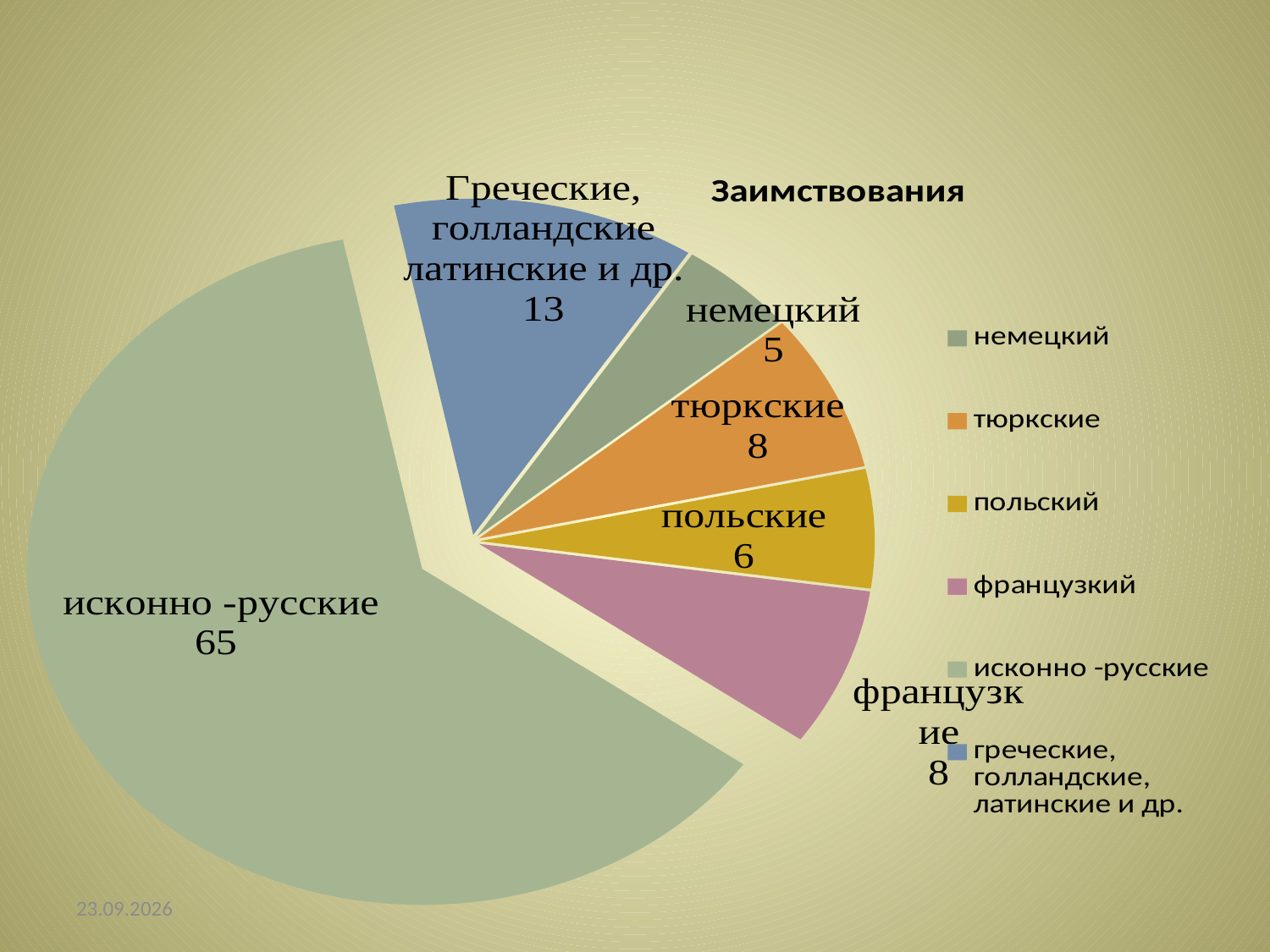
What is the value for греческие, голландские, латинские и др.? 13 Which is larger, the value for тюркские or the value for польские? тюркские What type of chart is shown on the slide? pie chart How many entries does the legend list? 6 Which category has the smallest slice? немецкий What is the value for исконно -русские? 65 What is the value for тюркские? 8 What is the difference between the values for исконно -русские and греческие, голландские, латинские и др.? 52 What is the title of the chart? Заимствования What is the value for польские? 6 Which category has the largest slice? исконно -русские What is the value for немецкий? 5